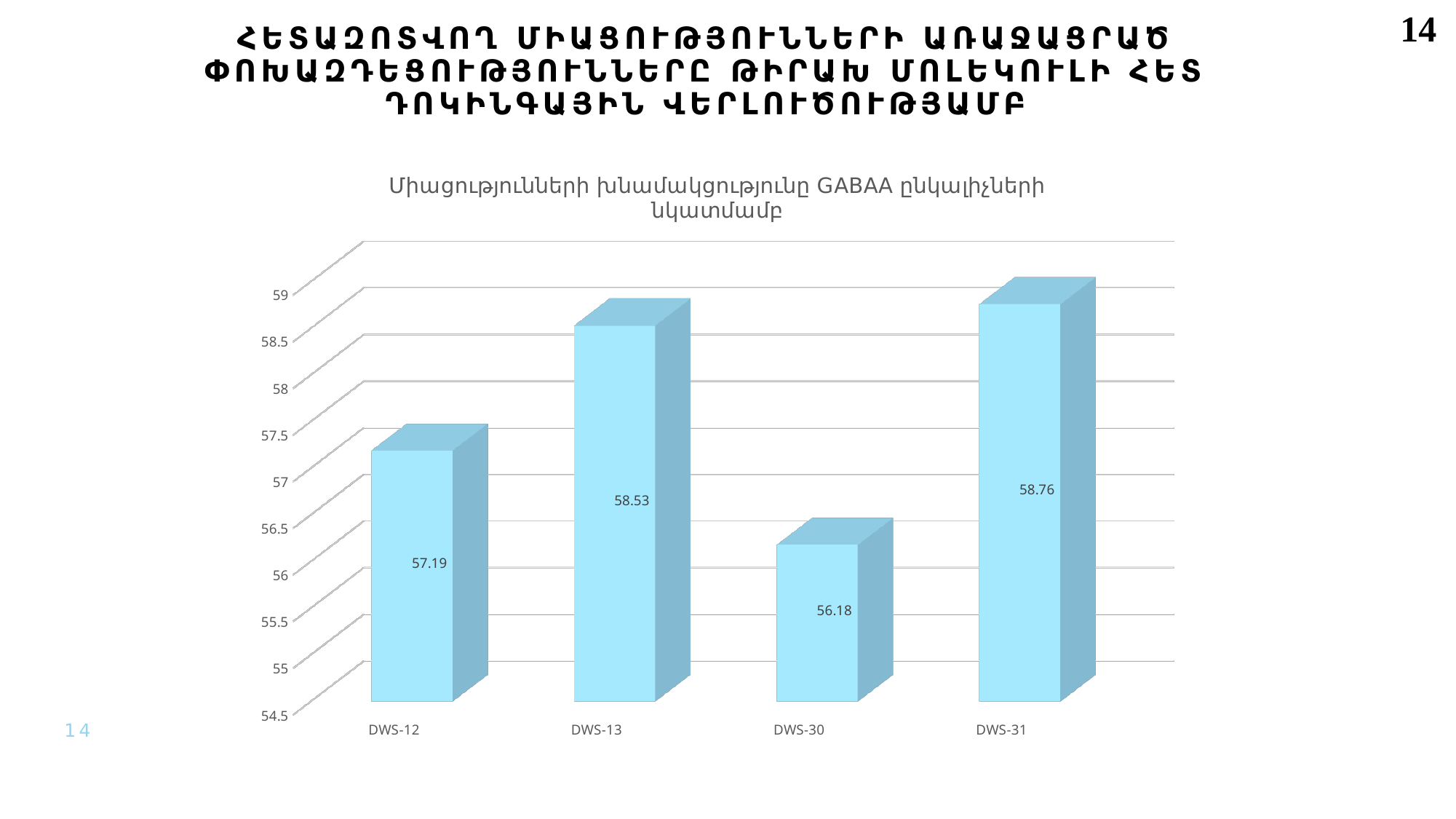
What is the difference between the values for DWS-13 and DWS-12? 1.34 What is the value for DWS-12? 57.19 Is the value for DWS-30 greater or less than 57? less What kind of chart is shown on the slide? bar chart What is the value for DWS-13? 58.53 Which category has the lowest value? DWS-30 What is the value for DWS-31? 58.76 How many categories are shown on the x axis? 4 What is the difference between the values for DWS-31 and DWS-30? 2.58 Which category has the highest value? DWS-31 Which is larger, the value for DWS-12 or the value for DWS-13? DWS-13 What is the value for DWS-30? 56.18